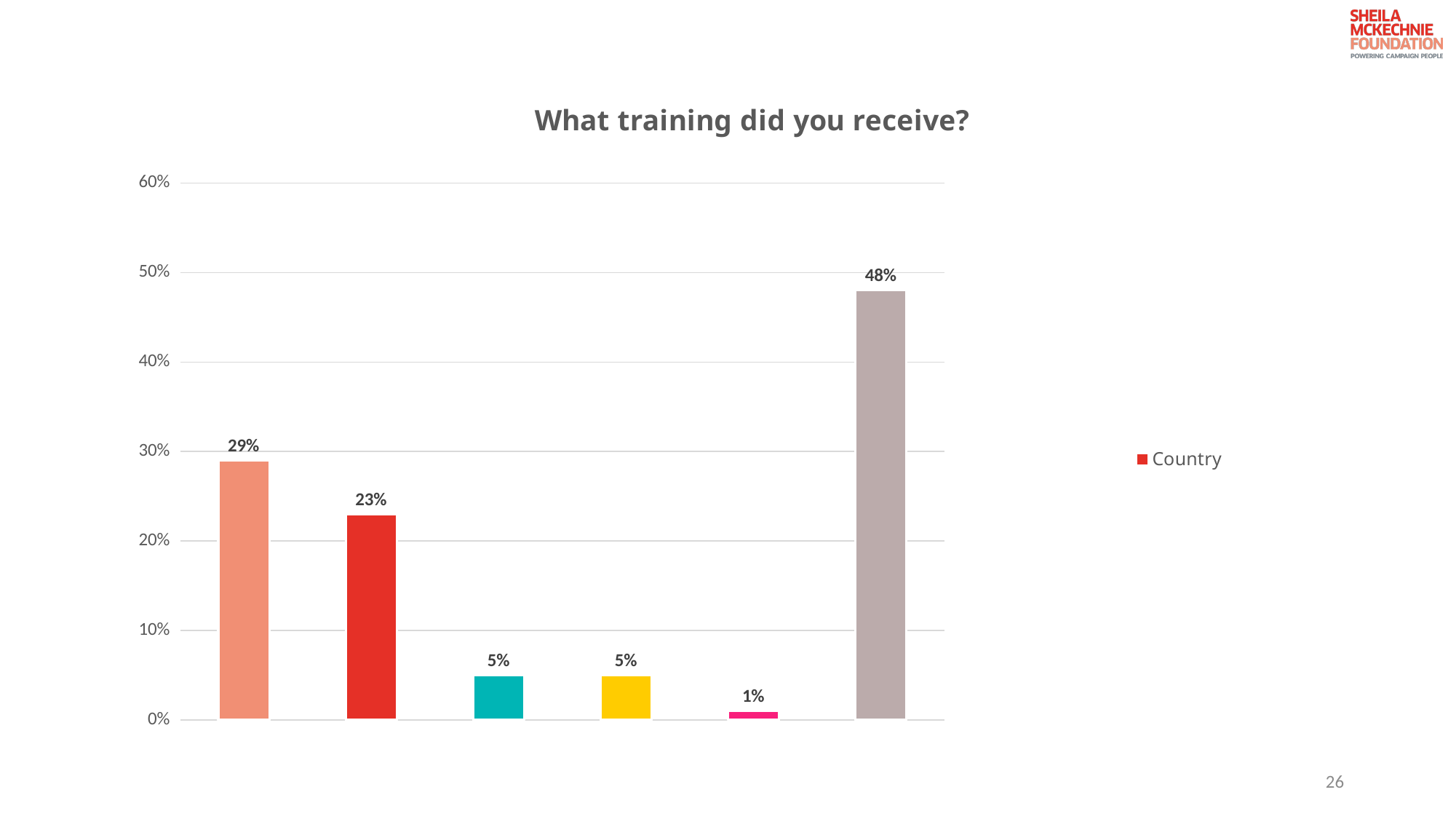
What is the lowest value shown in the chart? 1% What is the value of the second bar from the left? 23% What is the name of the series shown in the legend? Country How many series does the legend list? 1 What is the value of the first (leftmost) bar? 29% What is the value of the last (rightmost) bar? 48% What is the value of the pink bar (fifth from the left)? 1% What is the difference between the rightmost bar (48%) and the leftmost bar (29%)? 19% What is the highest value shown in the chart? 48% How many bars are plotted in the chart? 6 What type of chart is shown on the slide? bar chart What is the title of the chart? What training did you receive?